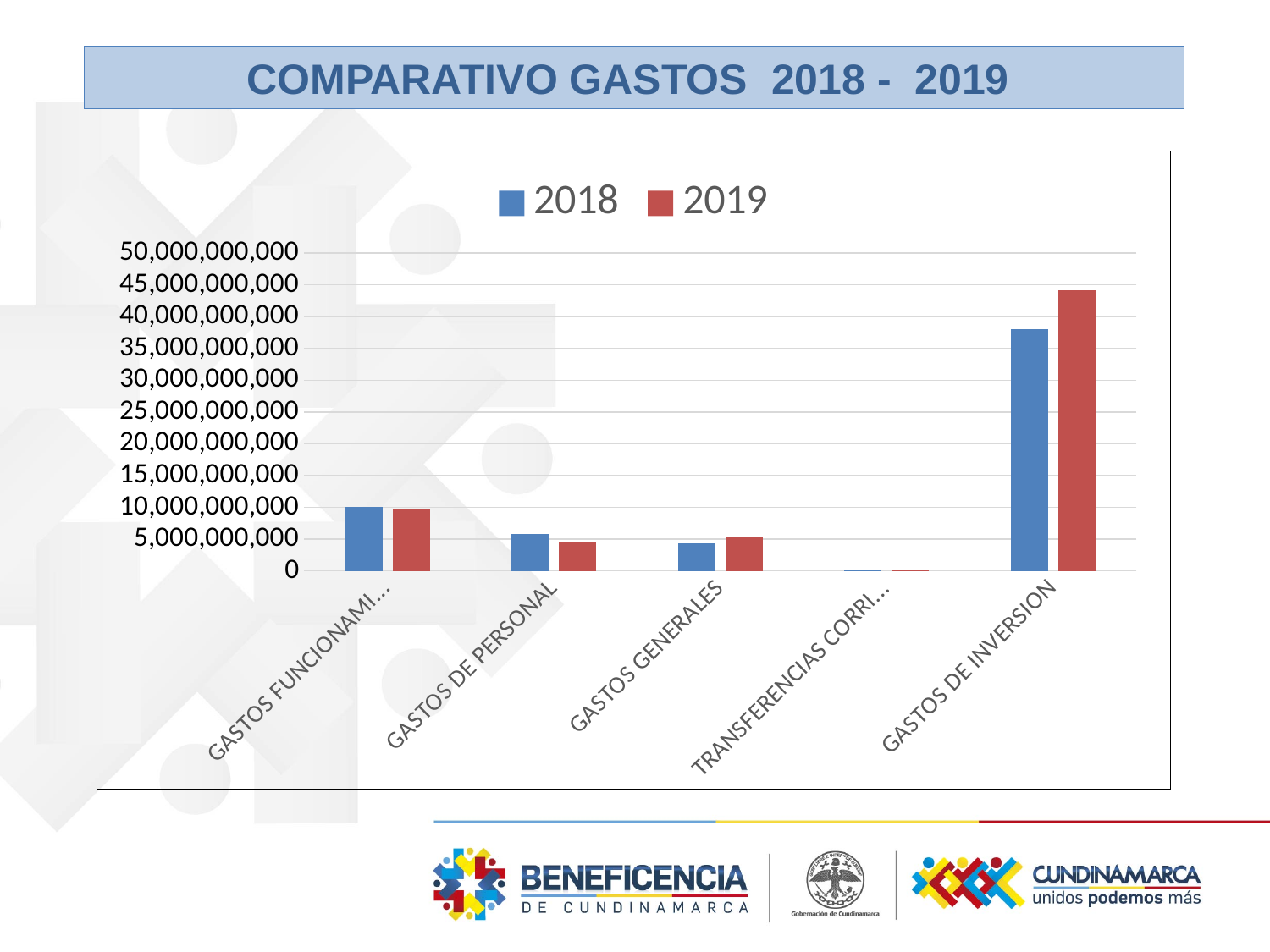
For GASTOS DE PERSONAL, which year has the larger value, 2018 or 2019? 2018 How many series does the legend list? 2 Which category has the highest value for 2019? GASTOS DE INVERSION What kind of chart is shown on the slide? bar chart Is the 2018 value for GASTOS DE PERSONAL greater or less than 5,000,000,000? greater How many categories are shown on the x axis? 5 Which series does the legend list? 2018 and 2019 Is the 2018 value for GASTOS DE INVERSION greater or less than 40,000,000,000? less Is the 2019 value for GASTOS DE INVERSION greater or less than 40,000,000,000? greater Which category has the highest value for 2018? GASTOS DE INVERSION For GASTOS DE INVERSION, which year has the larger value, 2018 or 2019? 2019